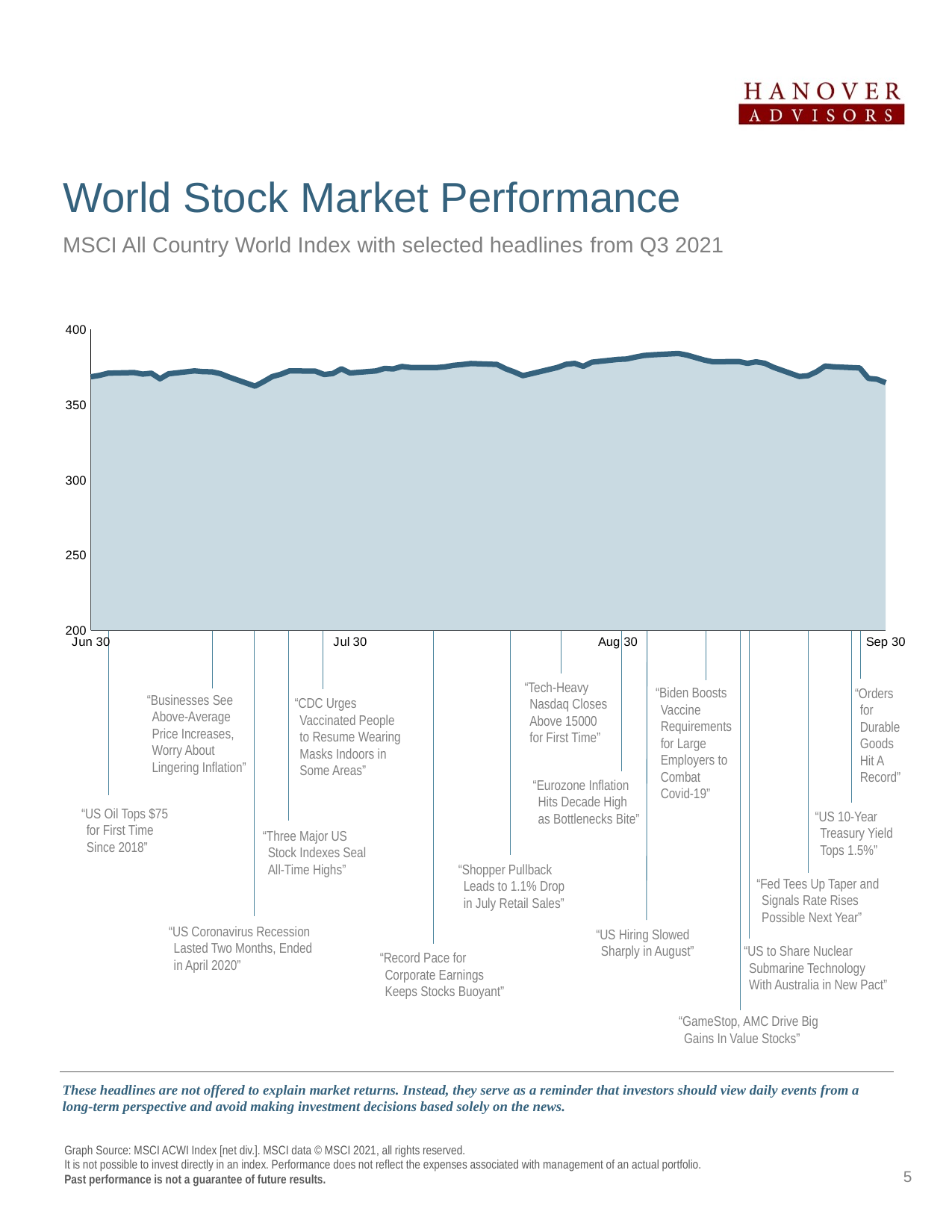
What is the title of the slide's chart? World Stock Market Performance What is the last date label on the x axis? Sep 30 Is the index value on Jul 30 greater or less than 350? greater Is the highest point of the index over the period greater or less than 400? less What kind of chart is shown on the slide? Area chart What is the first date label on the x axis? Jun 30 Is the index value on Sep 30 greater or less than 350? greater What is the lowest value shown on the y axis? 200 Which index does the chart plot, according to the subtitle? MSCI All Country World Index How many date labels are shown on the x axis? 4